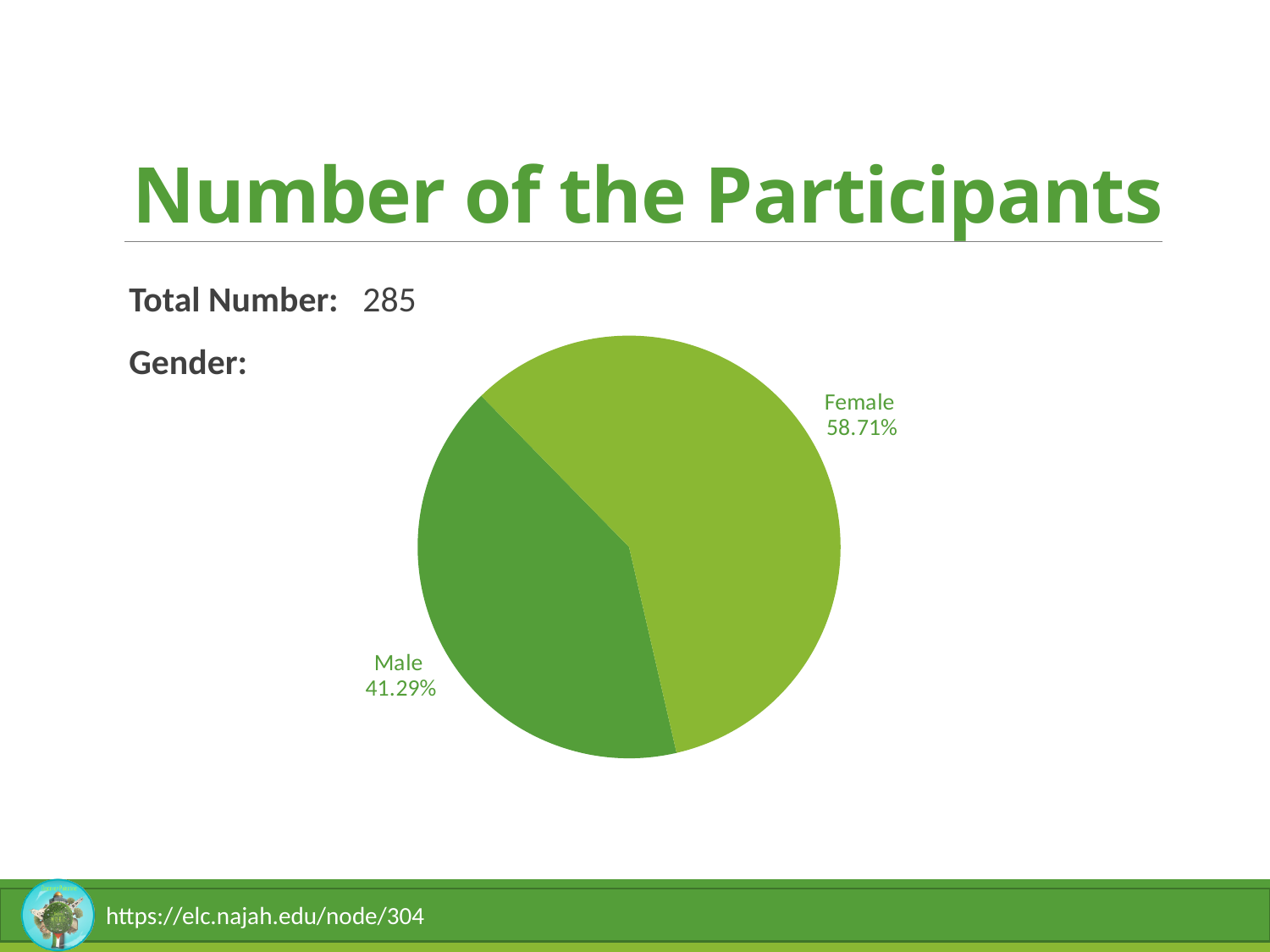
What percentage of participants are Male? 41.29% What is the title of the slide containing the pie chart? Number of the Participants What is the difference in percentage points between the Female and Male shares? 17.42 What kind of chart is shown on the slide? pie chart Which gender has the smaller share of participants? Male What percentage of participants are Female? 58.71% What is the total number of participants stated on the slide? 285 How many slices does the pie chart have? 2 What share of the pie does the Male slice represent? 41.29% Is the Female share larger or smaller than the Male share? larger Which gender has the larger share of participants? Female